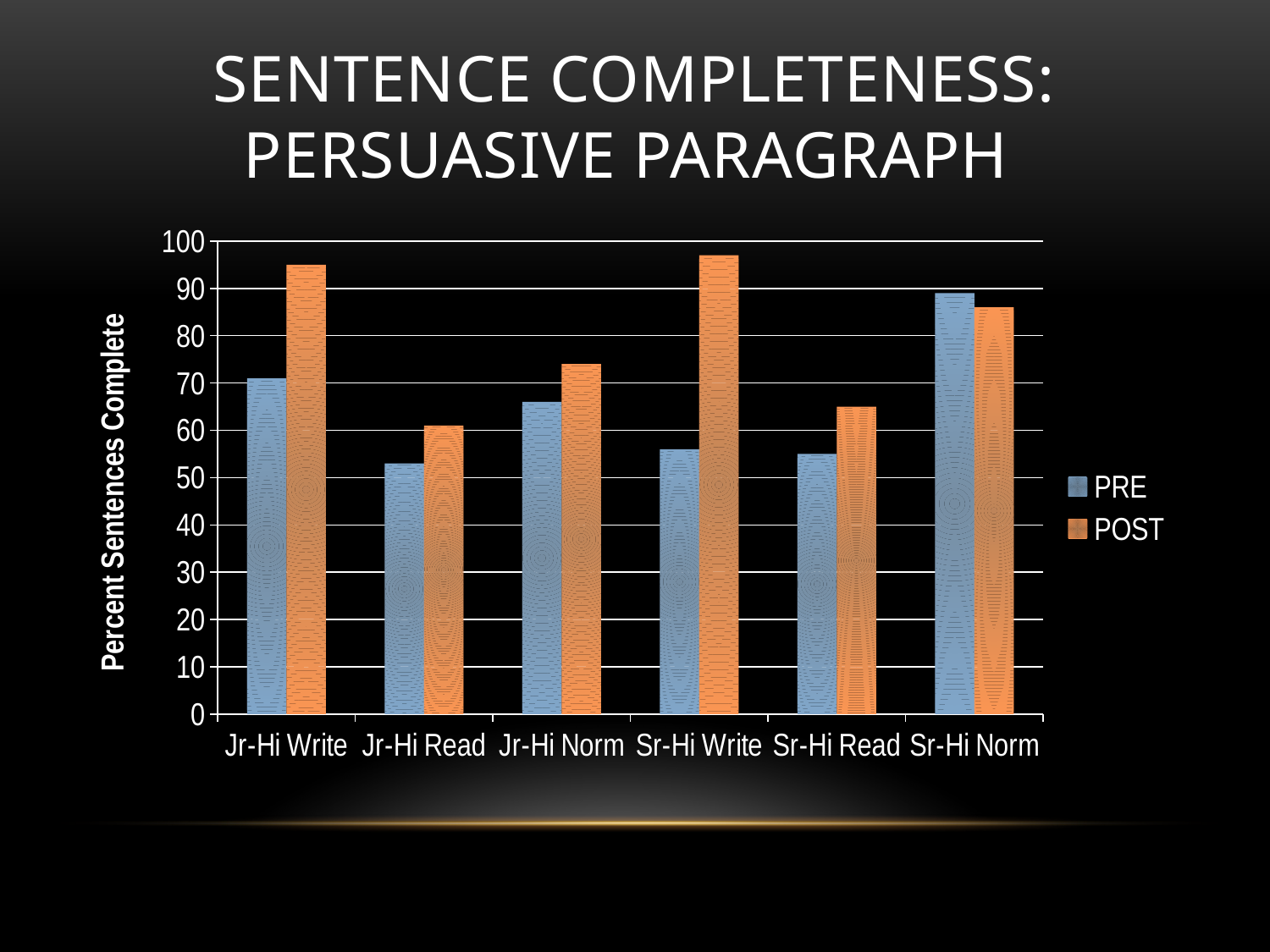
Is the PRE value for Sr-Hi Norm greater or less than 80? greater Is the PRE value for Sr-Hi Write greater or less than 60? less How many series does the legend list? 2 What is the label of the vertical axis? Percent Sentences Complete What kind of chart is shown on the slide? bar chart For Jr-Hi Write, which is larger, the PRE value or the POST value? POST Which category has the highest PRE value? Sr-Hi Norm How many categories are shown on the x axis? 6 Is the PRE value for Jr-Hi Read greater or less than 60? less For Sr-Hi Write, which is larger, the PRE value or the POST value? POST